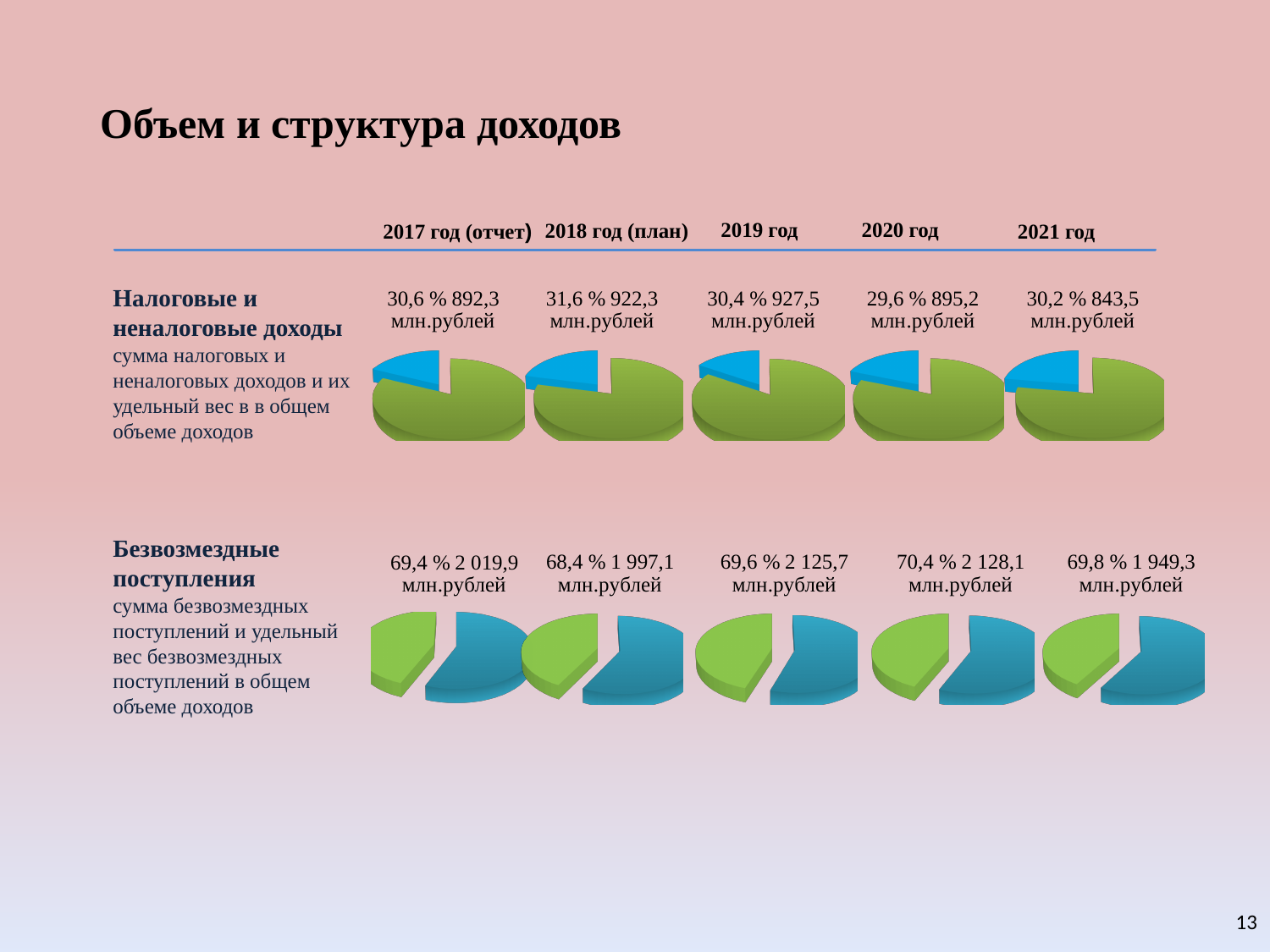
In the row 'Безвозмездные поступления', which year has the highest amount in млн.рублей? 2020 год In the row 'Безвозмездные поступления', what amount in млн.рублей is shown for 2021 год? 1 949,3 млн.рублей In the row 'Безвозмездные поступления', what is the difference in share between 2020 год and 2018 год (план)? 2,0 % In the row 'Налоговые и неналоговые доходы', which year has the highest share? 2018 год (план) How many pie charts are on the slide in total? 10 In the row 'Налоговые и неналоговые доходы', what amount in млн.рублей is shown for 2019 год? 927,5 млн.рублей In the row 'Налоговые и неналоговые доходы', which is larger: the amount for 2017 год (отчет) or for 2020 год? 2020 год In the row 'Налоговые и неналоговые доходы', which year has the lowest amount in млн.рублей? 2021 год In the row 'Безвозмездные поступления', what share is shown for 2020 год? 70,4 % In the row 'Безвозмездные поступления', what colour is the larger slice of each pie? Blue What type of charts are shown on the slide? Pie charts In the row 'Налоговые и неналоговые доходы', what share is shown for 2018 год (план)? 31,6 %